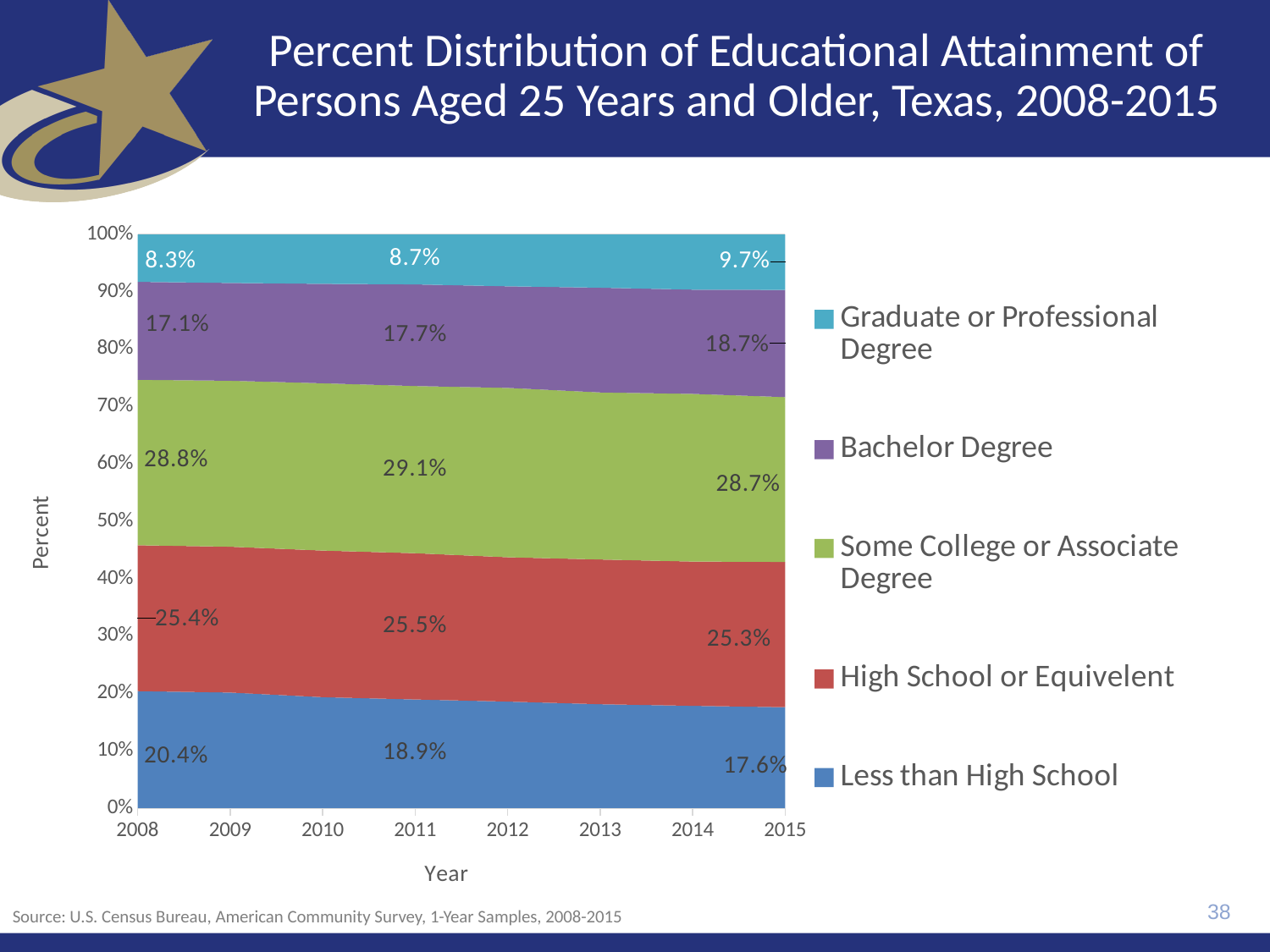
What is the value for Bachelor Degree in 2015? 18.7% What is the value for Some College or Associate Degree in 2011? 29.1% Which is larger in 2011: the share for High School or Equivelent or the share for Bachelor Degree? High School or Equivelent What kind of chart is shown on the slide? Stacked area chart What is the value for Graduate or Professional Degree in 2015? 9.7% What is the label of the x axis? Year Which educational attainment category has the lowest share in 2015? Graduate or Professional Degree Does the share of Graduate or Professional Degree rise or fall from 2008 to 2015? Rise What is the value for Less than High School in 2008? 20.4% How many series does the legend list? 5 Which educational attainment category has the highest share in 2008? Some College or Associate Degree By how many percentage points did the Less than High School share change from 2008 to 2015? 2.8 percentage points